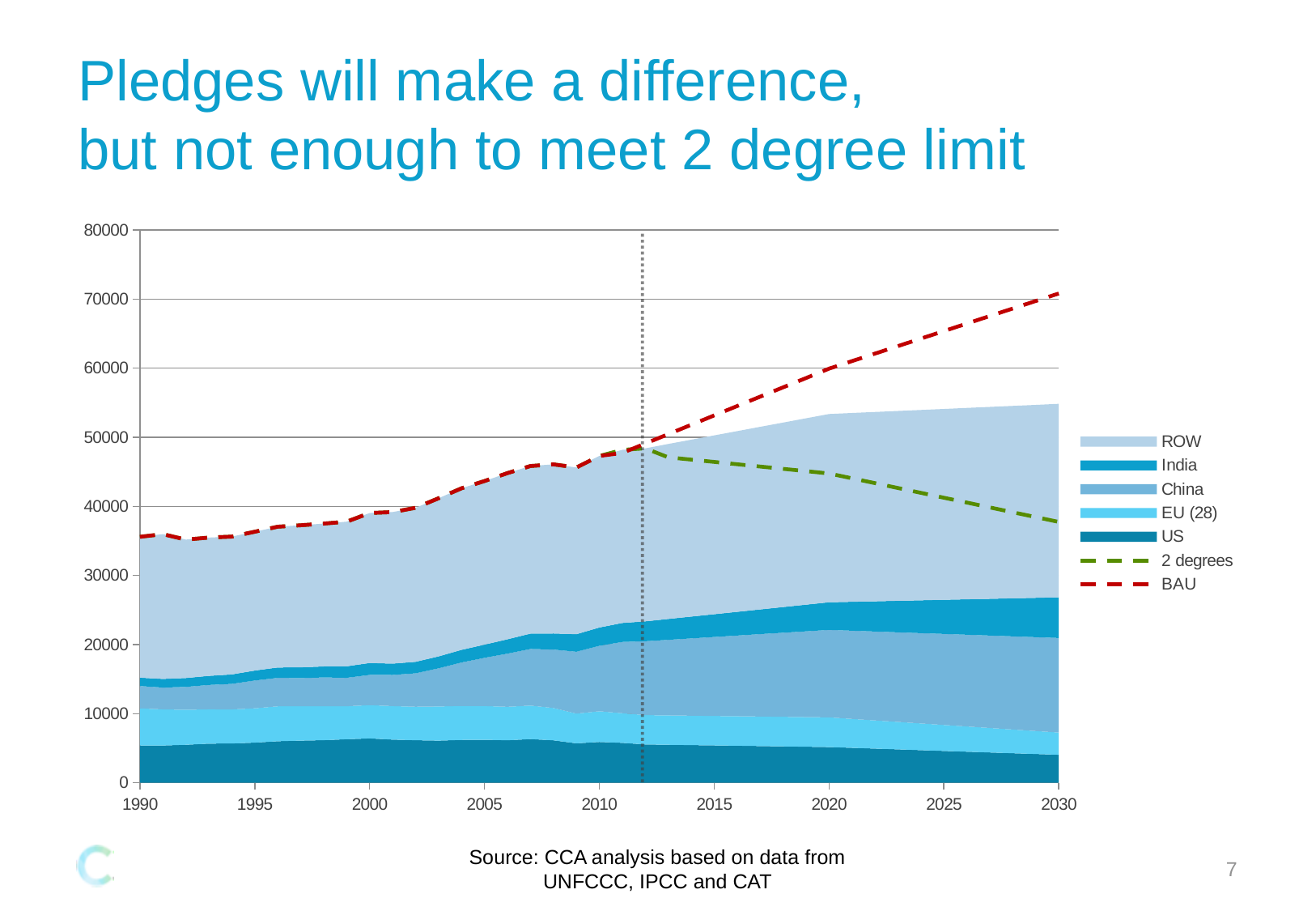
Does the BAU line rise or fall from 2012 to 2030? Rises Is the value of the 2 degrees line in 2030 greater or less than 40000? less Is the total of the stacked areas in 1990 greater or less than 40000? less What kind of chart is shown on the slide? Combination stacked area and line chart Does the 2 degrees line rise or fall from 2012 to 2030? Falls How many year labels are shown on the x axis? 9 Which series is at the bottom of the stacked areas? US In 2030, which is larger, the BAU line or the 2 degrees line? BAU What colour is the BAU line in the legend? Red (dashed) Is the total of the stacked areas in 2030 greater or less than 50000? greater How many entries does the legend list? 7